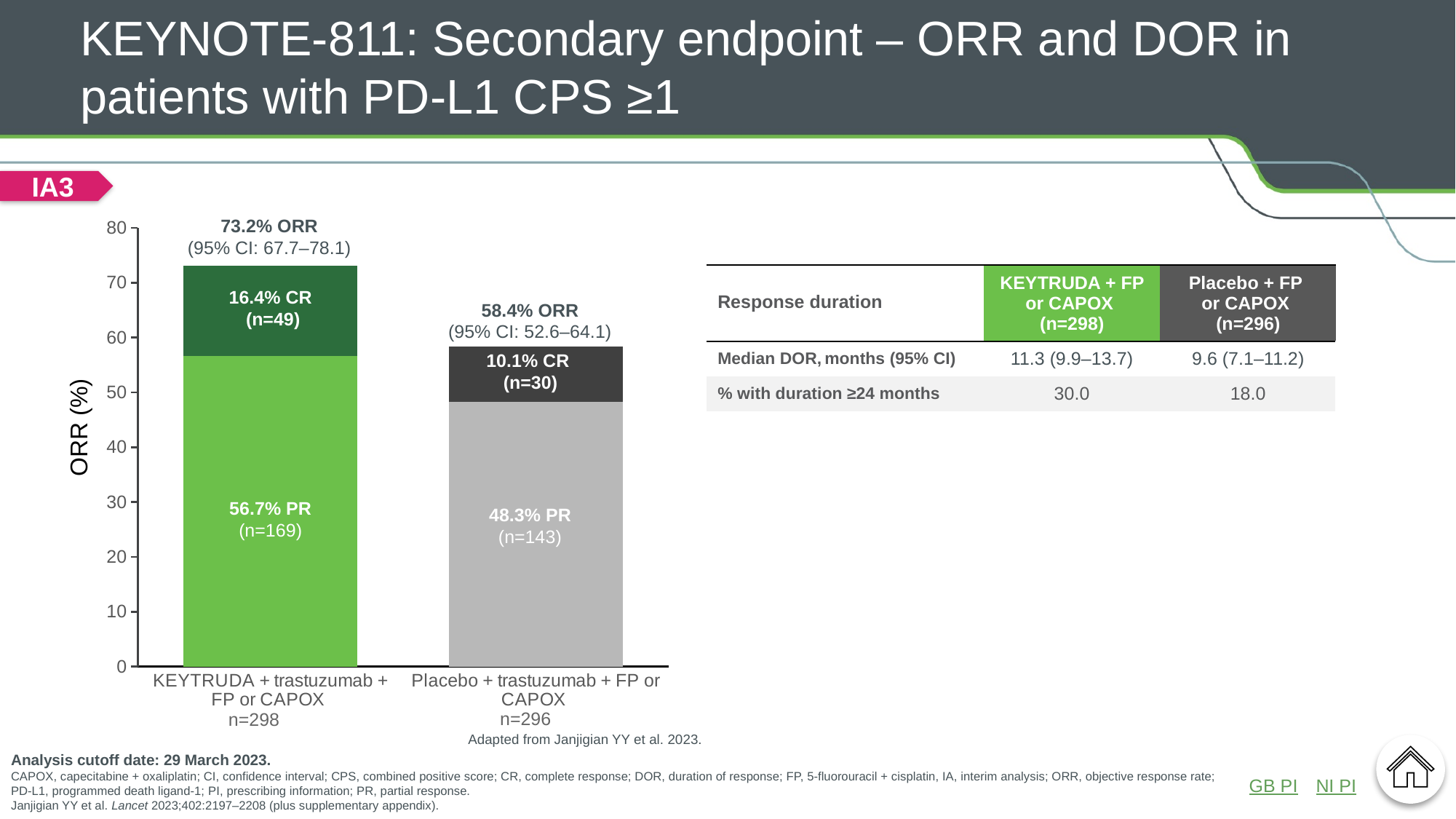
What is the ORR for the Placebo + trastuzumab + FP or CAPOX arm? 58.4% What is the ORR for the KEYTRUDA + trastuzumab + FP or CAPOX arm? 73.2% Is the PR rate larger in the KEYTRUDA arm or the Placebo arm? KEYTRUDA arm What is the partial response (PR) rate in the Placebo + trastuzumab + FP or CAPOX arm? 48.3% What type of chart is shown on the slide? Stacked bar chart What is the difference in CR rate between the KEYTRUDA arm and the Placebo arm? 6.3 percentage points Is the total bar height for the Placebo + trastuzumab + FP or CAPOX arm greater or less than 60? less What is the complete response (CR) rate in the KEYTRUDA + trastuzumab + FP or CAPOX arm? 16.4% What is the difference in ORR between the KEYTRUDA arm and the Placebo arm? 14.8 percentage points How many treatment arms (bars) are shown in the chart? 2 Which arm has the higher ORR? KEYTRUDA + trastuzumab + FP or CAPOX How many patients had a complete response in the Placebo + trastuzumab + FP or CAPOX arm? n=30